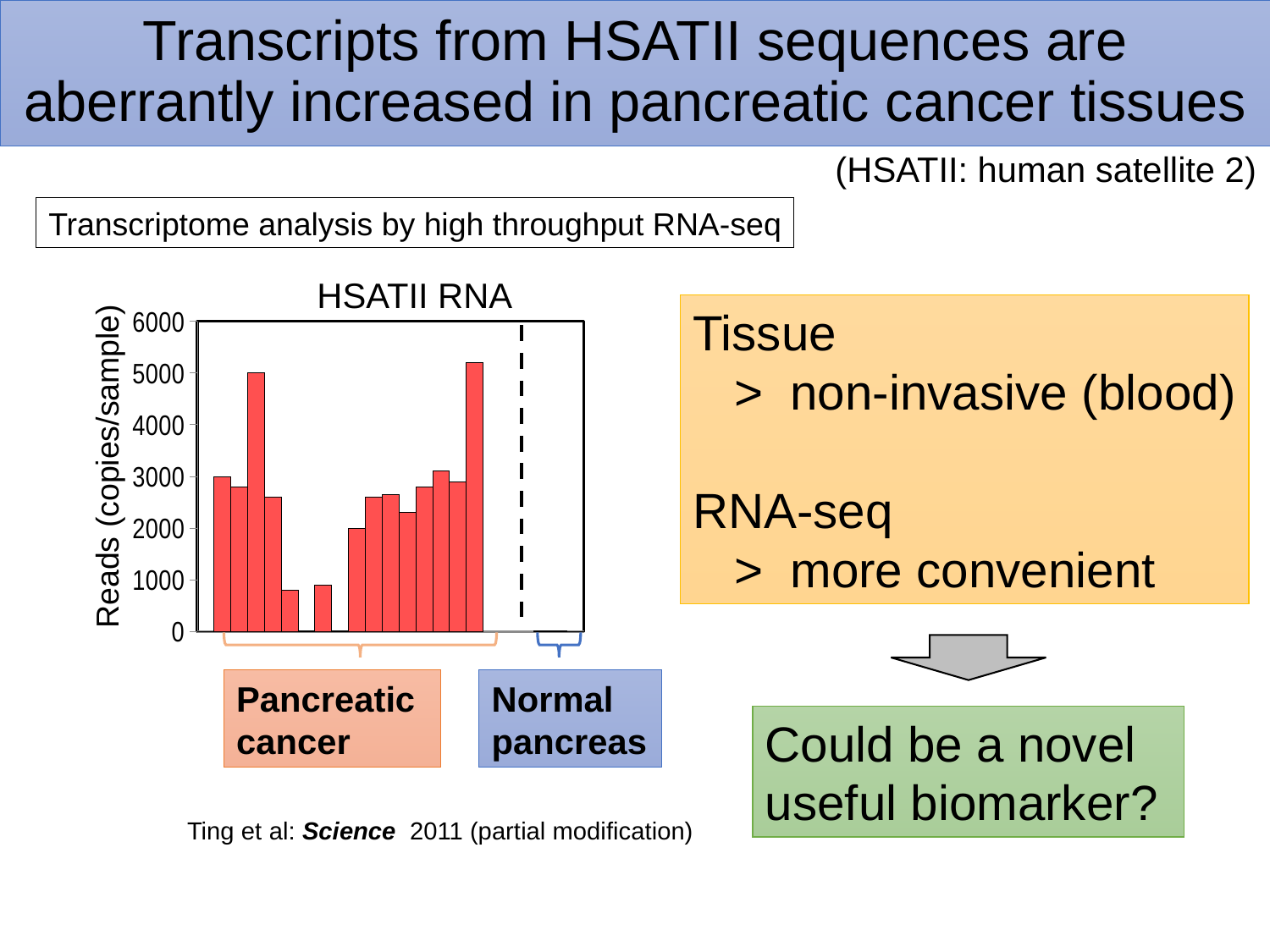
Is the value of the tallest bar in the pancreatic cancer group greater or less than 5000? greater What kind of chart is shown on the slide? bar chart Which group contains the bar with the highest number of reads? Pancreatic cancer What is the title of the chart? HSATII RNA Are the values for the normal pancreas samples greater or less than 1000? less What is the label of the y axis of the chart? Reads (copies/sample) Is the value of the shortest bar in the pancreatic cancer group greater or less than 1000? less How many tissue groups are labelled below the chart? 2 Which group shows higher HSATII RNA reads, pancreatic cancer or normal pancreas? Pancreatic cancer Which group has the lowest HSATII RNA reads? Normal pancreas